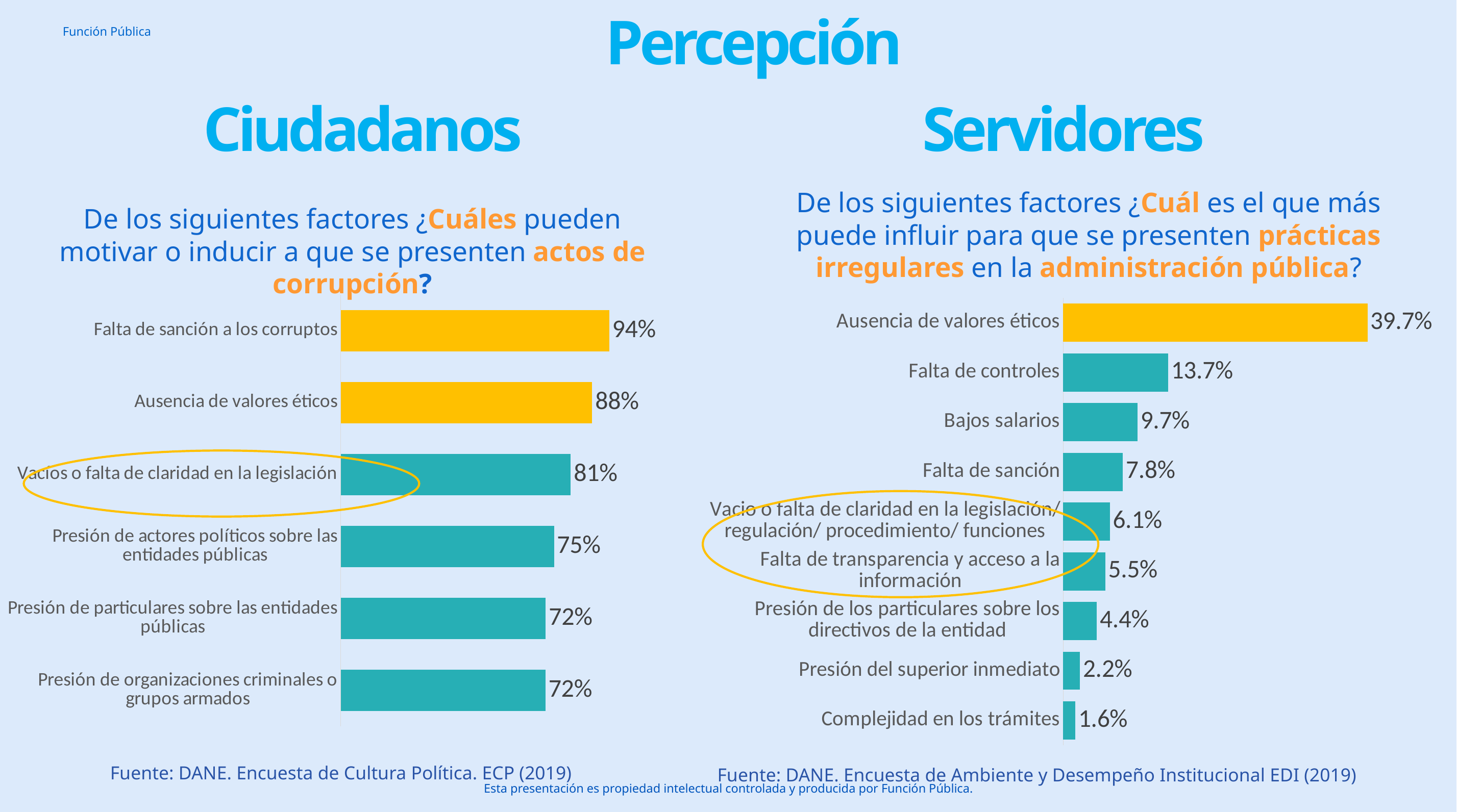
In the Servidores chart, how many categories are shown? 9 In the Servidores chart, what is the value for "Falta de transparencia y acceso a la información"? 5.5% In the Ciudadanos chart, which category has the highest value? Falta de sanción a los corruptos What type of chart is the Servidores chart? Bar chart In the Ciudadanos chart, how many categories are shown? 6 In the Servidores chart, which is larger: "Bajos salarios" or "Falta de sanción"? Bajos salarios In the Servidores chart, which category has the lowest value? Complejidad en los trámites In the Ciudadanos chart, what is the value for "Vacíos o falta de claridad en la legislación"? 81% In the Servidores chart, what is the difference between "Falta de controles" and "Bajos salarios"? 4.0% In the Ciudadanos chart, what is the difference between "Falta de sanción a los corruptos" and "Ausencia de valores éticos"? 6% In the Servidores chart, what is the value for "Ausencia de valores éticos"? 39.7% In the Ciudadanos chart, what is the value for "Falta de sanción a los corruptos"? 94%